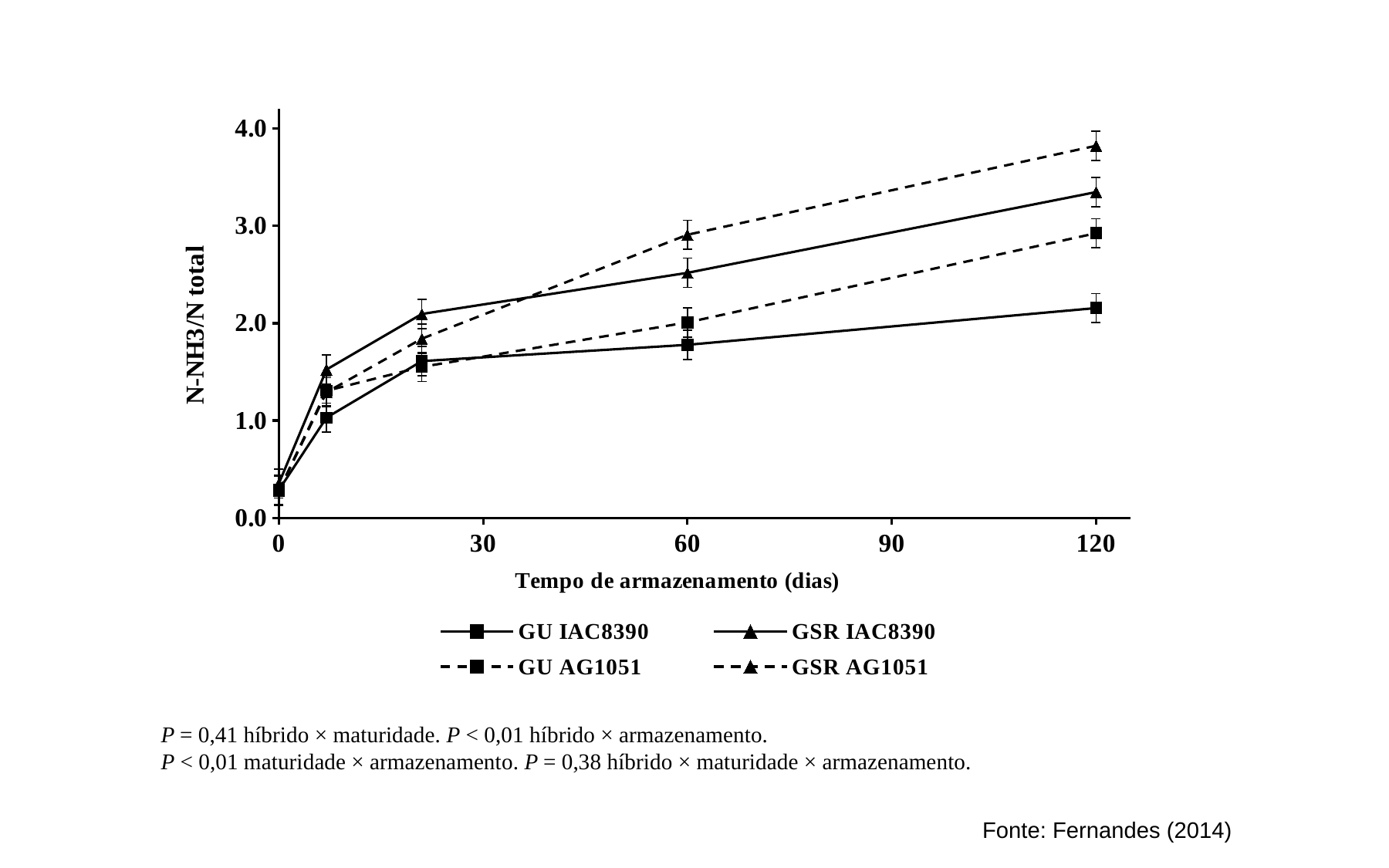
What is the title of the x axis? Tempo de armazenamento (dias) Which series has the highest value at 120 days? GSR AG1051 At 60 days, which is larger: GSR AG1051 or GU IAC8390? GSR AG1051 Do the values for GSR AG1051 rise or fall as storage time increases from 0 to 120 days? rise Is the value for GSR IAC8390 at 60 days greater or less than 3.0? less Which series has the lowest value at 120 days? GU IAC8390 Is the value for GU IAC8390 at 60 days greater or less than 2.0? less What is the title of the y axis? N-NH3/N total How many series does the legend list? 4 Is the value for GSR AG1051 at 120 days greater or less than 3.0? greater What kind of chart is shown on the slide? line chart